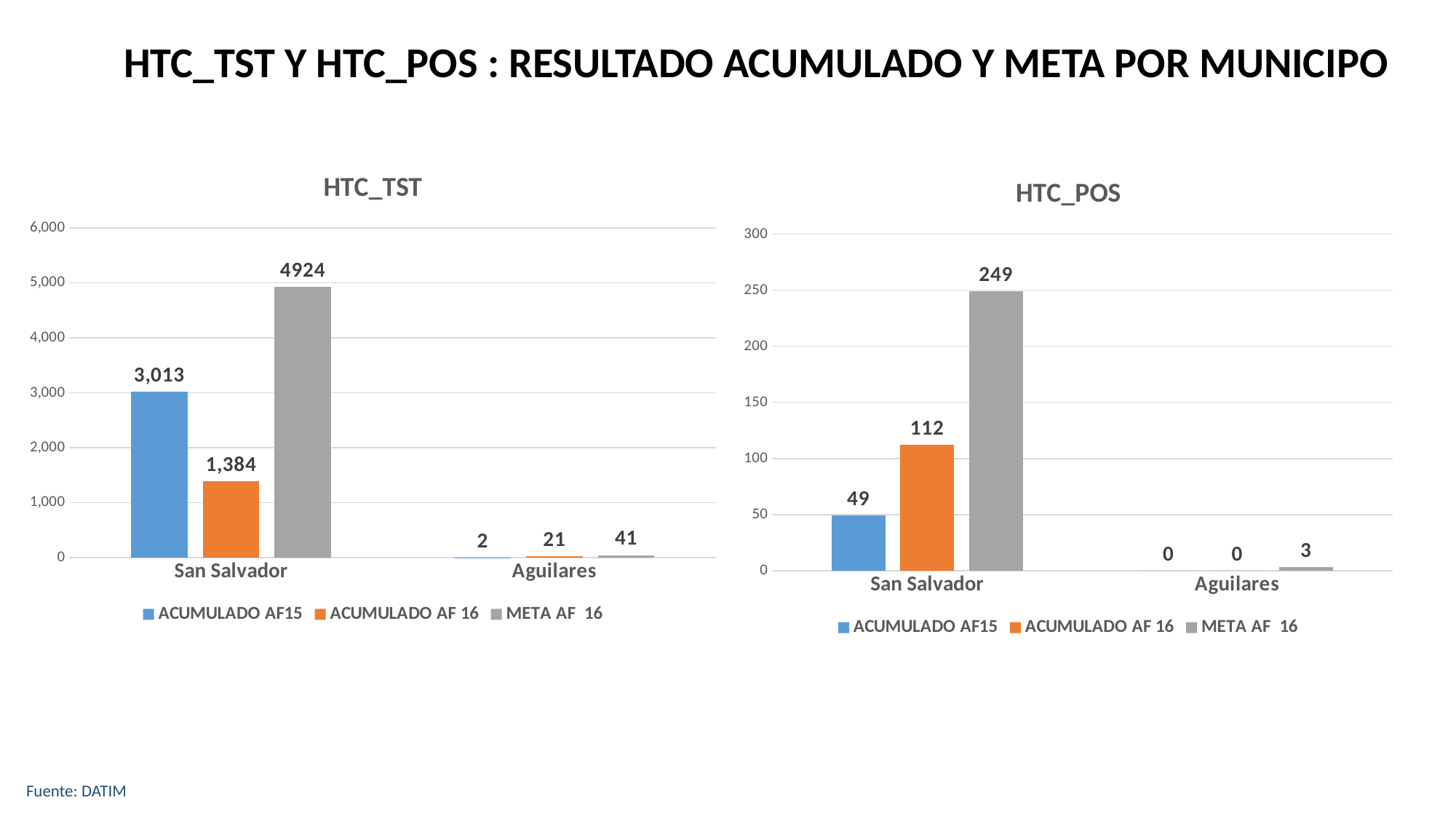
How many series does the legend of the HTC_TST chart list? 3 In the HTC_POS chart, what is the difference between ACUMULADO AF 16 and ACUMULADO AF15 for San Salvador? 63 In the HTC_POS chart, which series has the highest value for San Salvador? META AF 16 In the HTC_TST chart, what is the ACUMULADO AF 16 value for Aguilares? 21 In the HTC_TST chart, what is the difference between META AF 16 and ACUMULADO AF 16 for San Salvador? 3540 In the HTC_POS chart, is the ACUMULADO AF15 value for San Salvador larger or smaller than the ACUMULADO AF 16 value for San Salvador? smaller In the HTC_TST chart, what is the value of ACUMULADO AF15 for San Salvador? 3,013 In the HTC_TST chart, which series has the lowest value for Aguilares? ACUMULADO AF15 What kind of chart is the HTC_POS chart? bar chart In the HTC_POS chart, what is the ACUMULADO AF 16 value for San Salvador? 112 In the HTC_TST chart, what is the META AF 16 value for San Salvador? 4924 In the HTC_POS chart, what is the META AF 16 value for Aguilares? 3